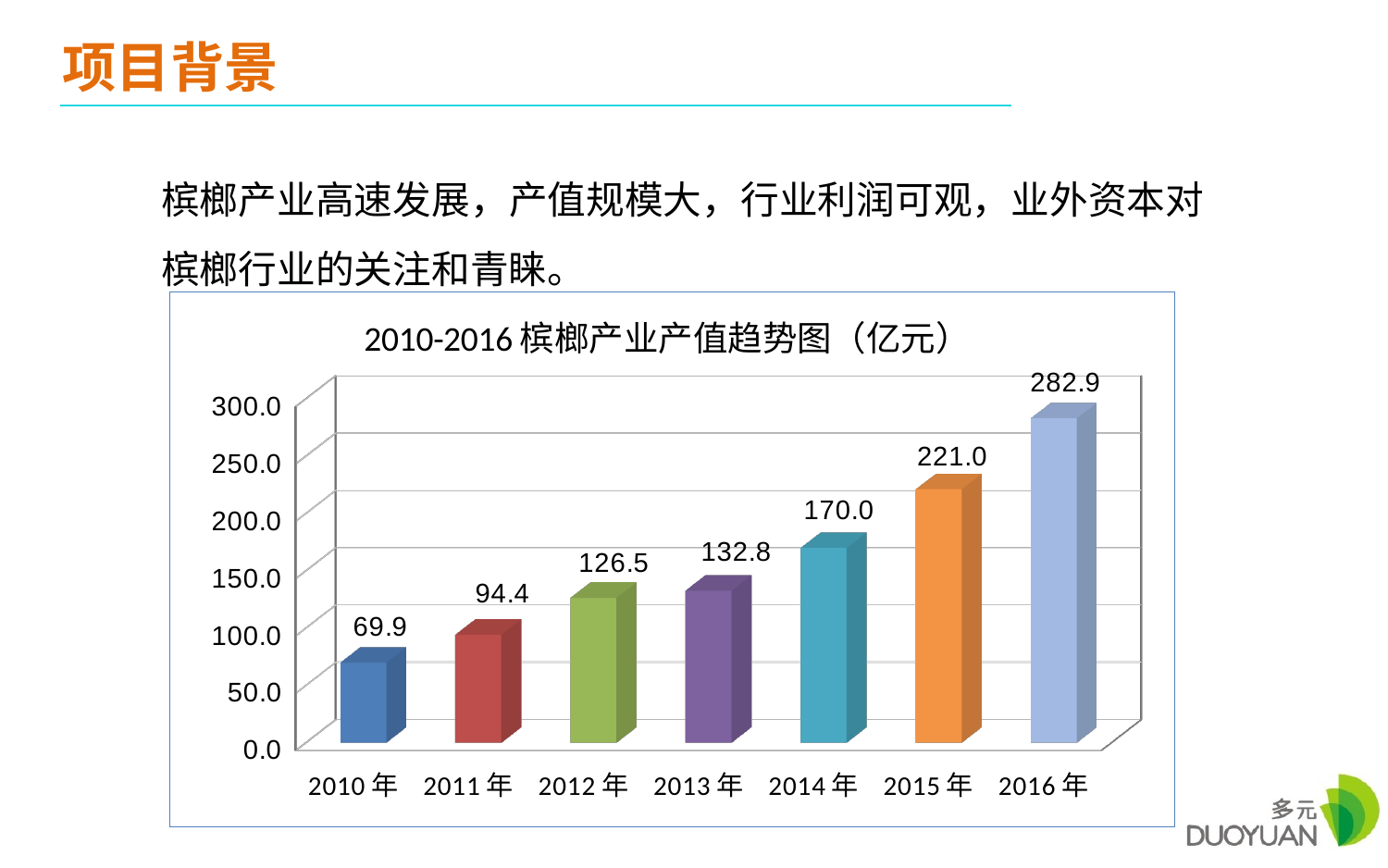
Do the values rise or fall from 2010年 to 2016年? rise What is the value for 2014年? 170.0 What is the difference between the values for 2013年 and 2012年? 6.3 What is the value for 2011年? 94.4 What is the title of the chart? 2010-2016 槟榔产业产值趋势图（亿元） Which year has the lowest value? 2010年 What kind of chart is shown? bar chart How many years are shown on the x axis? 7 What is the difference between the values for 2016年 and 2015年? 61.9 Which year has the highest value? 2016年 Is the value for 2015年 greater or less than 200.0? greater Which is larger, the value for 2012年 or the value for 2014年? 2014年